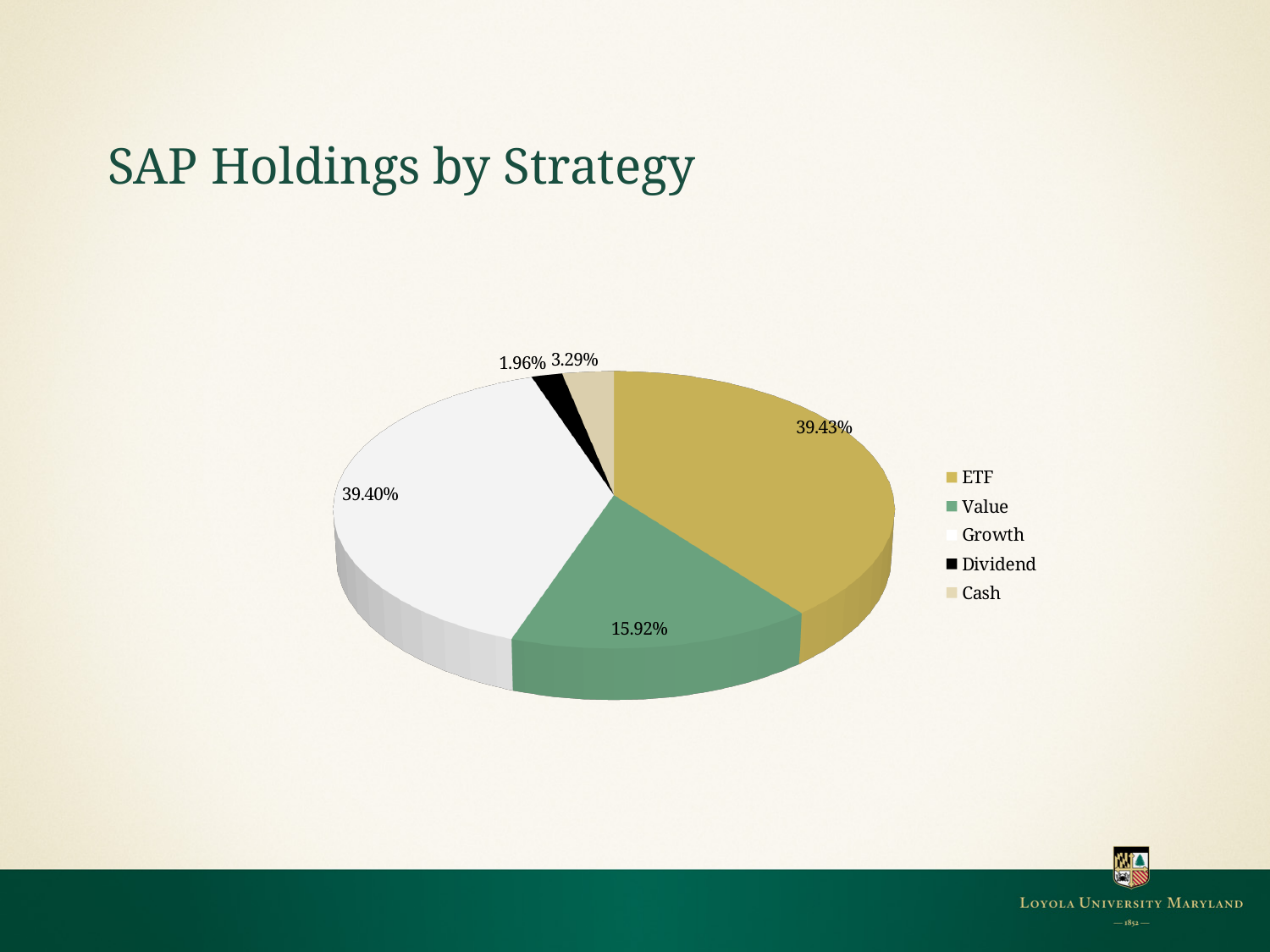
How many percentage points larger is the ETF share than the Value share? 23.51% What share of holdings is Cash? 3.29% What share of SAP holdings is in ETF? 39.43% What type of chart is shown on the slide? Pie chart How many strategies are shown in the pie chart? 5 What share does Growth represent in the pie chart? 39.40% What percentage of holdings is in Dividend? 1.96% Which is larger, the Cash share or the Dividend share? Cash Which strategy has the smallest share of holdings? Dividend What is the difference between the Cash share and the Dividend share? 1.33% What percentage of holdings is in the Value strategy? 15.92% Which is larger, the ETF share or the Value share? ETF